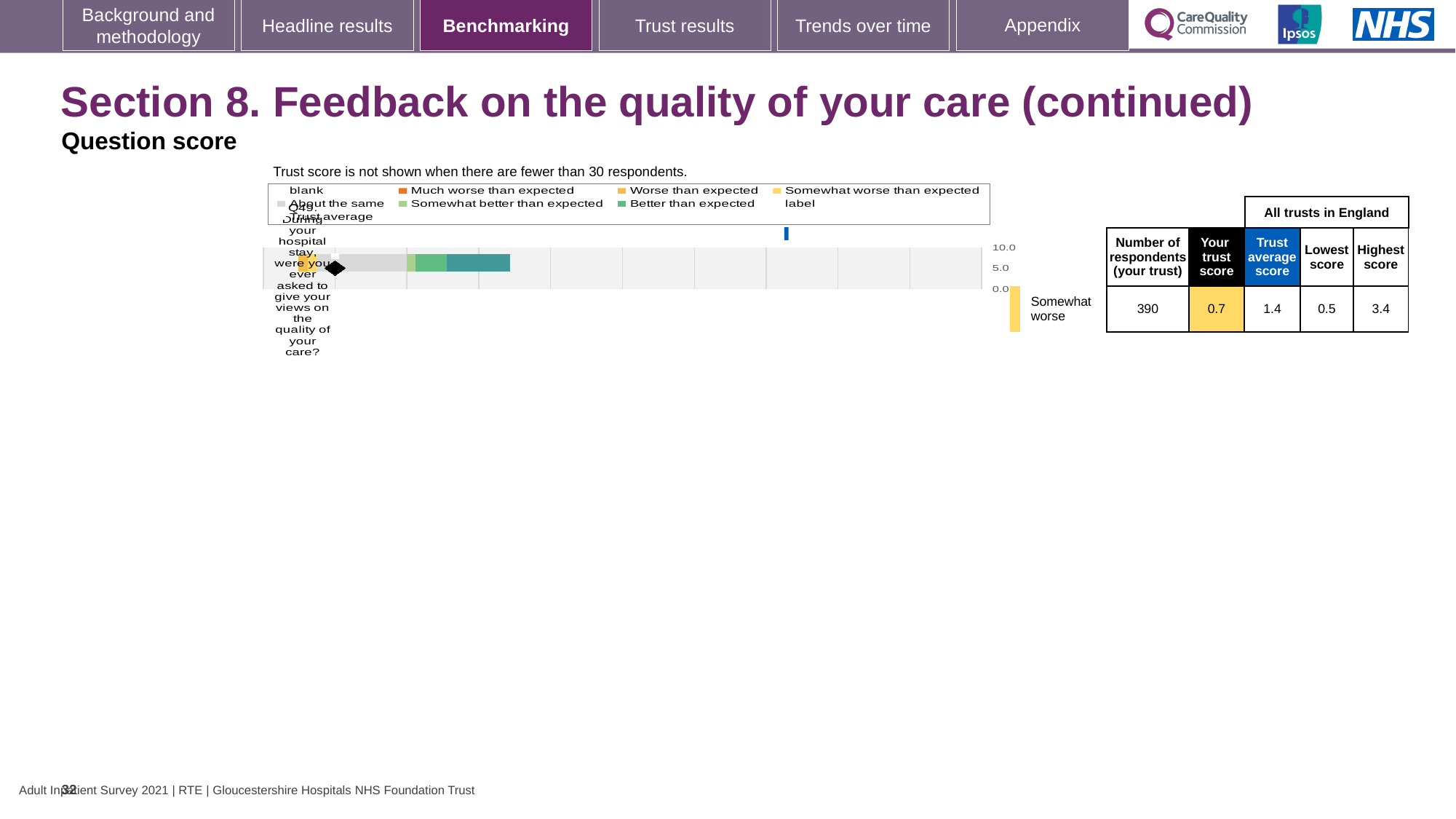
What is the highest score for Q49 among all trusts in England? 3.4 Which is larger for Q49: your trust score or the trust average score? Trust average score How many respondents from the trust answered Q49? 390 What benchmark category label is shown beside the chart for Q49? Somewhat worse What is the difference between the highest and lowest scores for Q49 across all trusts in England? 2.9 What is the lowest score for Q49 among all trusts in England? 0.5 What is the trust score for Q49 shown in the table next to the chart? 0.7 What kind of chart is shown on the slide? bar chart What is the difference between the trust average score and your trust score for Q49? 0.7 How many questions (categories) are plotted in the chart? 1 What is the trust average score for Q49 across all trusts in England? 1.4